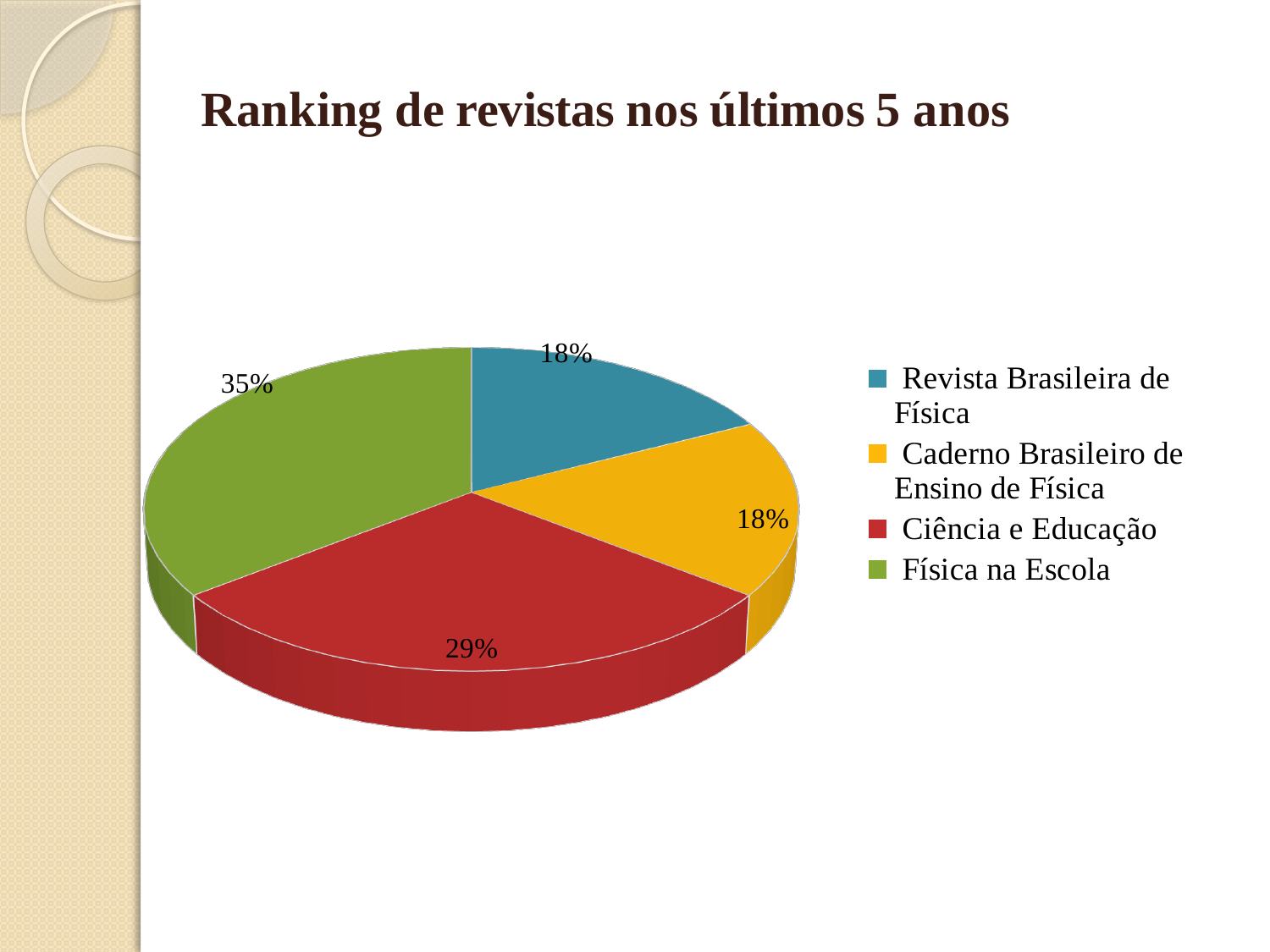
How many slices does the pie chart have? 4 What share of the pie does Ciência e Educação have? 29% What share of the pie does Física na Escola have? 35% What kind of chart is shown on the slide? pie chart What share of the pie does Caderno Brasileiro de Ensino de Física have? 18% How many entries does the legend list? 4 Which journal has the largest slice of the pie? Física na Escola What is the difference between the shares of Física na Escola and Ciência e Educação? 6% What is the title of the slide? Ranking de revistas nos últimos 5 anos Which colour represents Ciência e Educação in the pie chart? red Which is larger, the share of Ciência e Educação or the share of Revista Brasileira de Física? Ciência e Educação